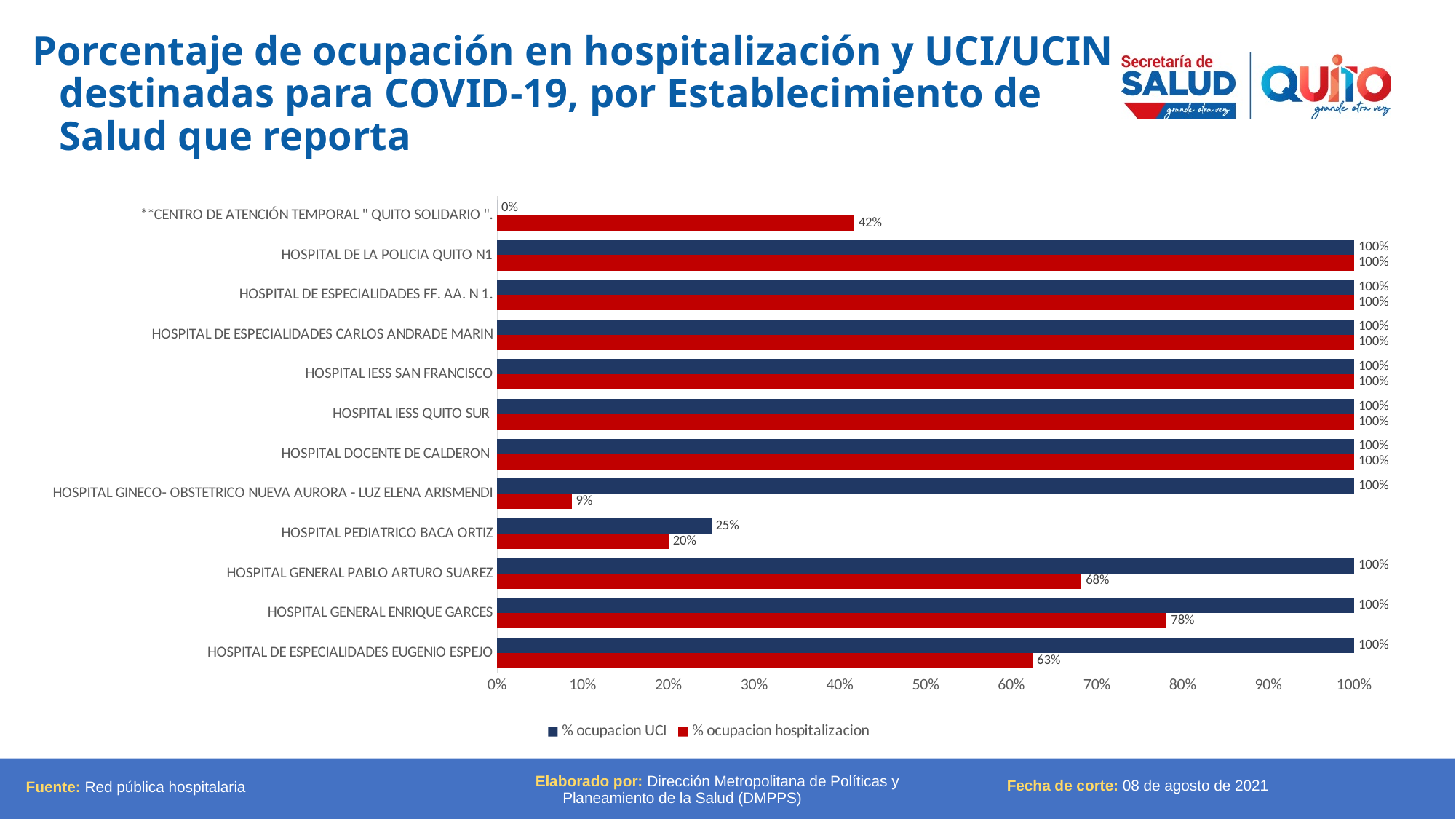
Which is larger for HOSPITAL DE ESPECIALIDADES EUGENIO ESPEJO: % ocupacion UCI or % ocupacion hospitalizacion? % ocupacion UCI What is the % ocupacion hospitalizacion value for HOSPITAL GINECO- OBSTETRICO NUEVA AURORA - LUZ ELENA ARISMENDI? 9% What is the difference between the % ocupacion UCI and % ocupacion hospitalizacion values for HOSPITAL GENERAL PABLO ARTURO SUAREZ? 32% Which establishment has the lowest % ocupacion hospitalizacion? HOSPITAL GINECO- OBSTETRICO NUEVA AURORA - LUZ ELENA ARISMENDI What kind of chart is shown on the slide? Bar chart How many establishments are shown on the chart? 12 What is the % ocupacion hospitalizacion value for HOSPITAL GENERAL ENRIQUE GARCES? 78% What is the % ocupacion UCI value for HOSPITAL PEDIATRICO BACA ORTIZ? 25% How many series does the legend list? 2 Which establishment has the lowest % ocupacion UCI? CENTRO DE ATENCIÓN TEMPORAL "QUITO SOLIDARIO" What is the % ocupacion hospitalizacion value for CENTRO DE ATENCIÓN TEMPORAL "QUITO SOLIDARIO"? 42% Is the % ocupacion hospitalizacion value for HOSPITAL GENERAL ENRIQUE GARCES greater or less than 70%? greater